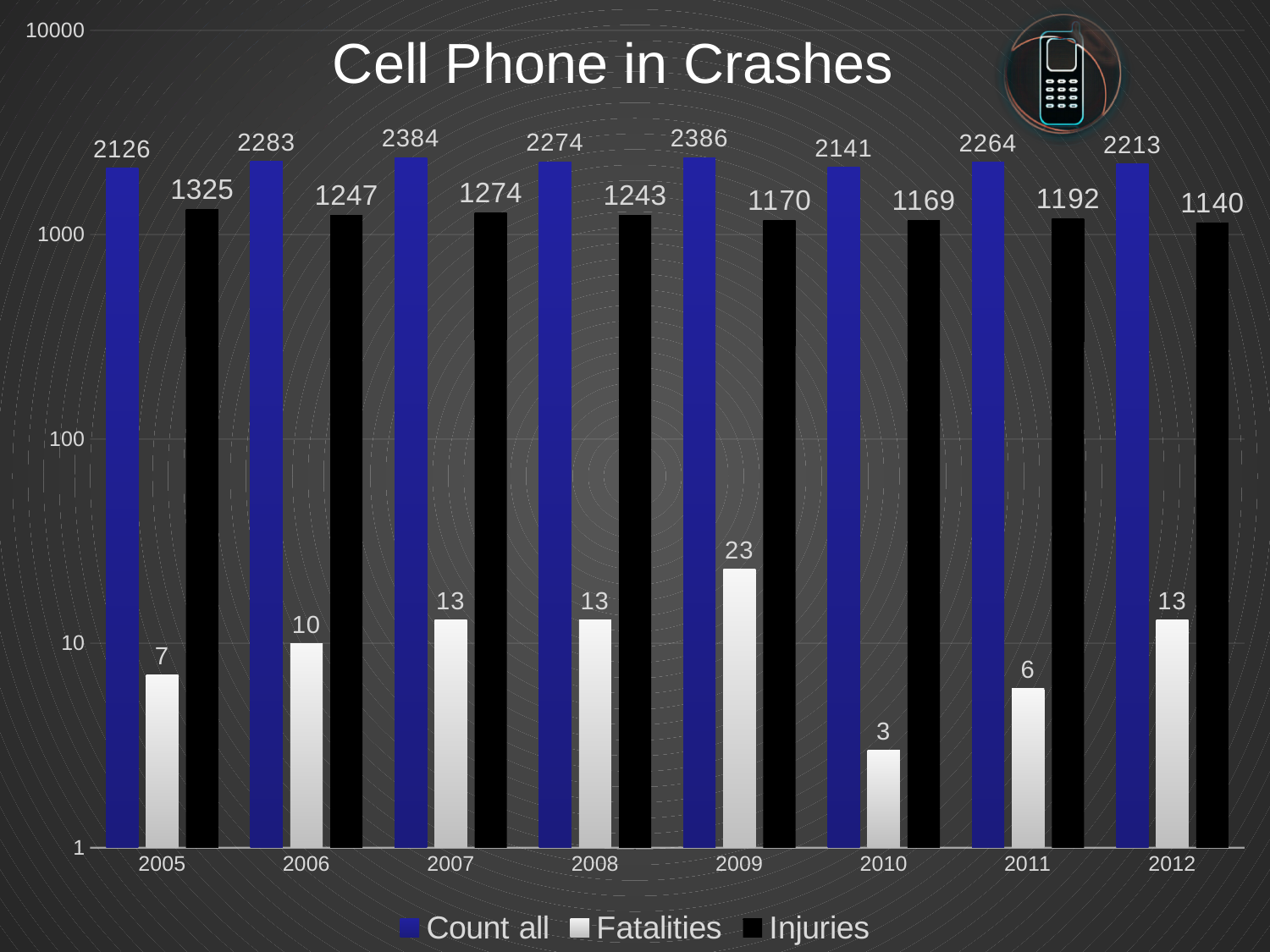
How many series does the legend list? 3 What is the Count all value for 2005? 2126 Which year has the highest Fatalities value? 2009 What type of chart is shown on the slide? Bar chart What is the Fatalities value for 2011? 6 Which year has the lowest Fatalities value? 2010 Which year has the lowest Injuries value? 2012 What is the Injuries value for 2008? 1243 Which is larger, the Count all value for 2006 or for 2010? 2006 What is the difference between the Injuries value in 2005 and in 2012? 185 How many years are shown on the x axis? 8 What is the title of the chart? Cell Phone in Crashes